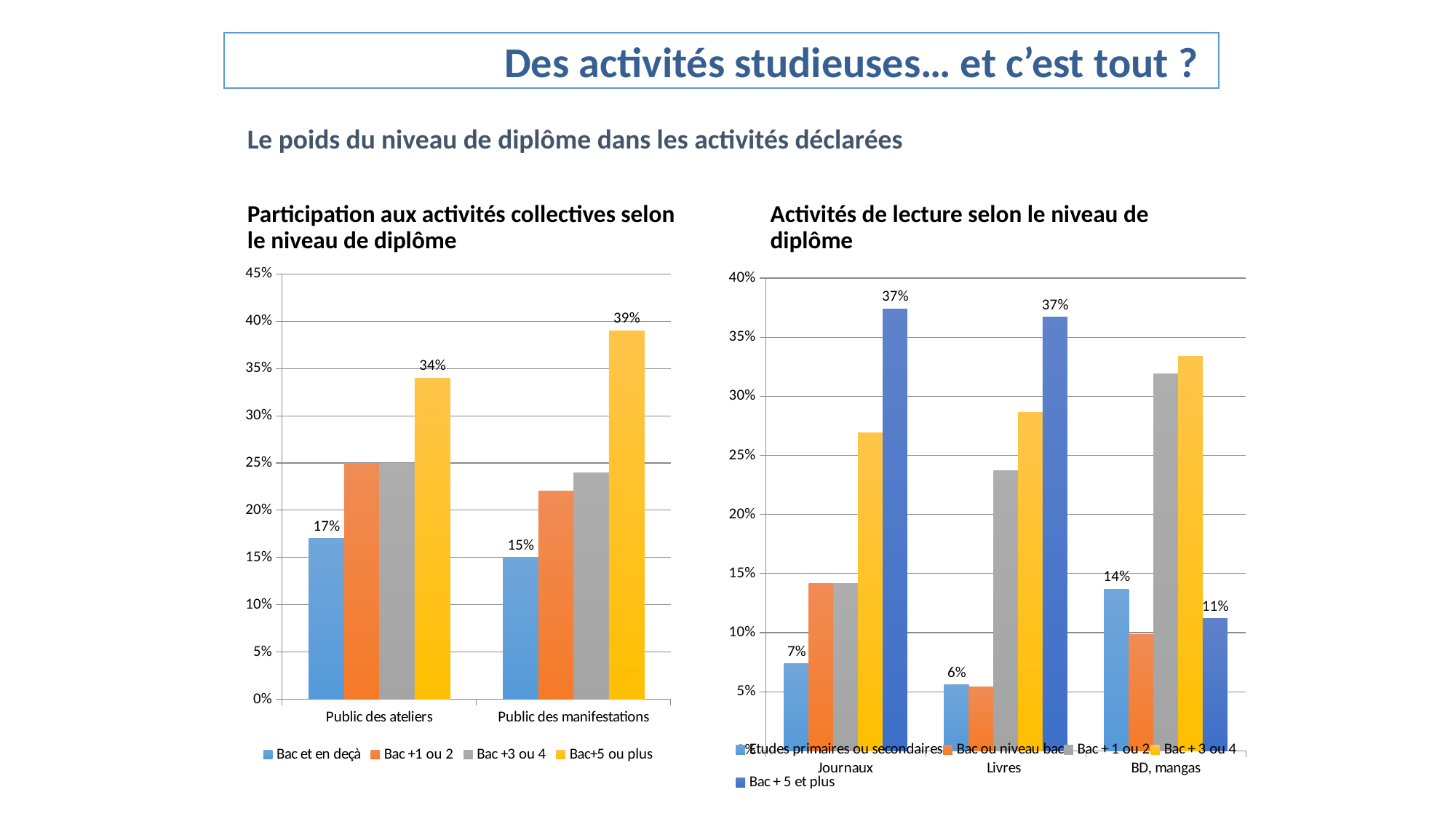
In the chart 'Activités de lecture selon le niveau de diplôme', what is the value for Études primaires ou secondaires in BD, mangas? 14% In the chart 'Participation aux activités collectives selon le niveau de diplôme', which diploma level has the highest value for Public des ateliers? Bac+5 ou plus In the chart 'Activités de lecture selon le niveau de diplôme', what is the value for Bac + 5 et plus in Journaux? 37% In the chart 'Participation aux activités collectives selon le niveau de diplôme', what is the value for Bac+5 ou plus in Public des manifestations? 39% How many categories are shown on the x axis of the chart 'Activités de lecture selon le niveau de diplôme'? 3 What kind of chart is 'Activités de lecture selon le niveau de diplôme'? Bar chart How many series does the legend of the chart 'Participation aux activités collectives selon le niveau de diplôme' list? 4 In the chart 'Activités de lecture selon le niveau de diplôme', is the value for Bac + 3 ou 4 in BD, mangas greater or less than 30%? greater In the chart 'Participation aux activités collectives selon le niveau de diplôme', what is the value for Bac et en deçà in Public des ateliers? 17% In the chart 'Activités de lecture selon le niveau de diplôme', for BD, mangas, which is larger: Études primaires ou secondaires or Bac + 5 et plus? Études primaires ou secondaires In the chart 'Participation aux activités collectives selon le niveau de diplôme', what is the difference between the Bac+5 ou plus values for Public des manifestations and Public des ateliers? 5 percentage points How many series does the legend of the chart 'Activités de lecture selon le niveau de diplôme' list? 5